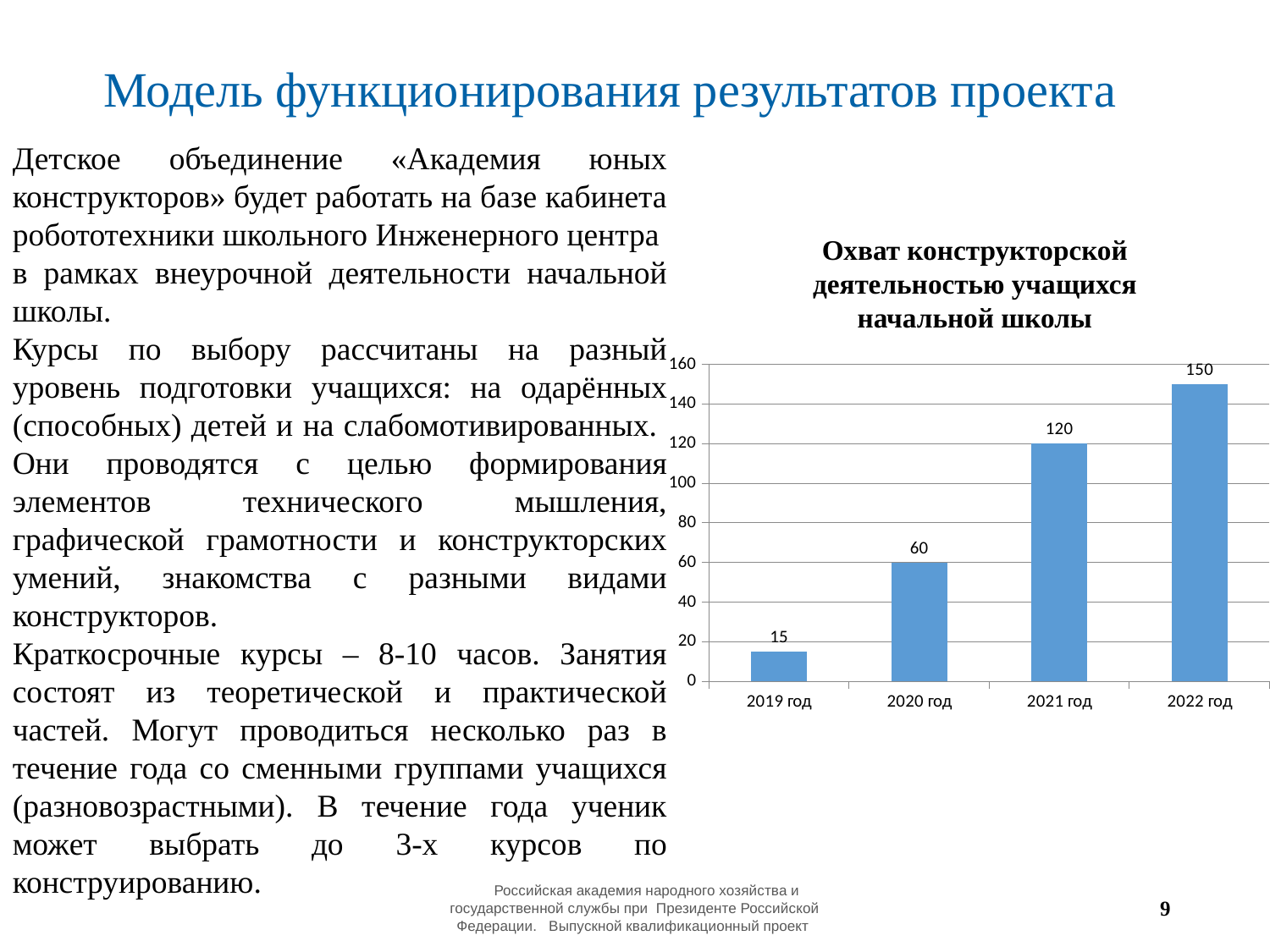
Which year has the lowest value? 2019 год What is the value for 2019 год? 15 What is the difference between the values for 2020 год and 2019 год? 45 What is the difference between the values for 2022 год and 2021 год? 30 How many years are shown on the x axis? 4 What is the value for 2021 год? 120 Is the value for 2020 год greater or less than 80? less Which is larger, the value for 2020 год or the value for 2021 год? 2021 год What kind of chart is shown on the slide? bar chart What is the value for 2022 год? 150 Do the values rise or fall from 2019 год to 2022 год? rise Which year has the highest value? 2022 год